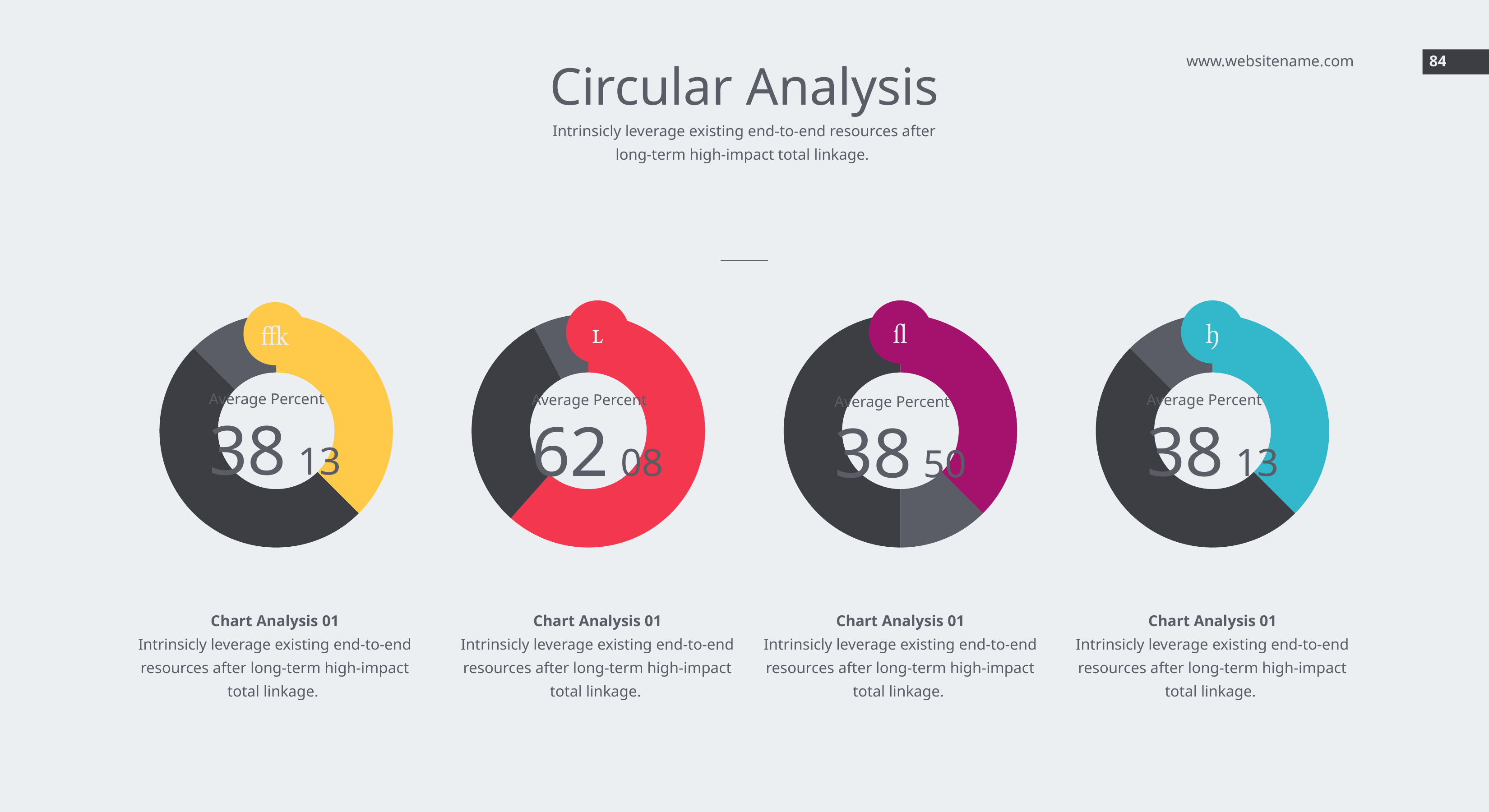
How many donut charts are shown on the slide? 4 What smaller number appears next to the large number in the second (red) donut chart? 08 What label is printed above the number in the centre of each donut chart? Average Percent Which donut chart shows the highest large centre number? The second (red) chart, 62 What is the difference between the large centre numbers of the second (red) and first (yellow) donut charts? 24 What large number is printed in the centre of the second (red) donut chart? 62 Is the large centre number of the second (red) donut chart larger or smaller than that of the first (yellow) donut chart? Larger What kind of chart is used for each of the four figures on the slide? Donut (pie) chart What is the colour of the highlighted segment in the third donut chart? Magenta (purple) What smaller number appears next to the large number in the fourth (teal) donut chart? 13 What large number is printed in the centre of the first (yellow) donut chart? 38 What smaller number appears next to the large number in the third (magenta) donut chart? 50